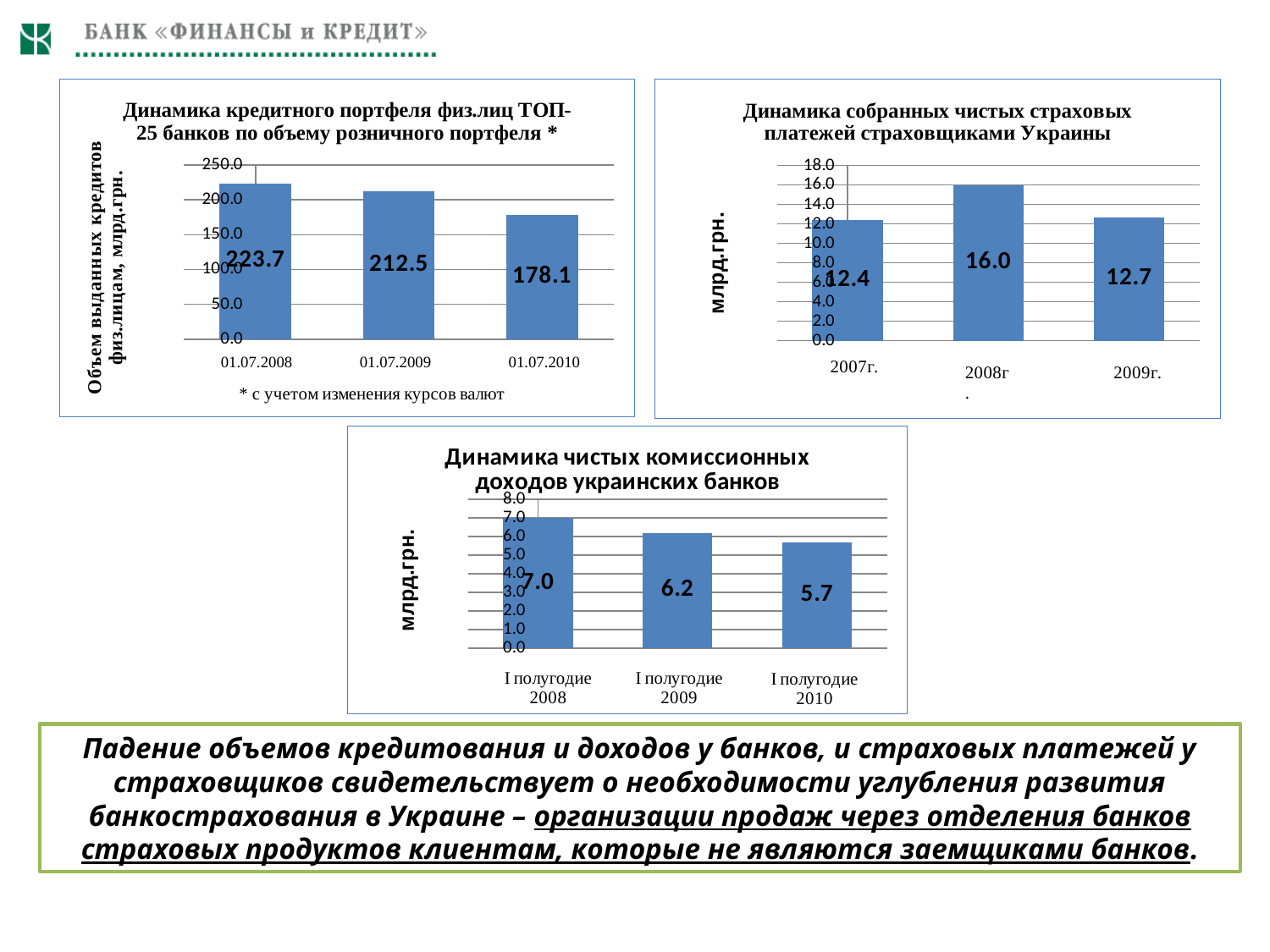
In the top-left chart (Динамика кредитного портфеля физ.лиц ТОП-25 банков), what is the difference between the values for 01.07.2008 and 01.07.2010? 45.6 In the top-left chart (Динамика кредитного портфеля физ.лиц ТОП-25 банков), what is the value for 01.07.2010? 178.1 In the top-left chart (Динамика кредитного портфеля физ.лиц ТОП-25 банков), which date has the highest value? 01.07.2008 In the top-right chart (Динамика собранных чистых страховых платежей страховщиками Украины), which is larger, the value for 2008г. or 2009г.? 2008г. In the top-right chart (Динамика собранных чистых страховых платежей страховщиками Украины), what is the difference between the values for 2008г. and 2007г.? 3.6 In the bottom chart (Динамика чистых комиссионных доходов украинских банков), what kind of chart is it? bar chart In the bottom chart (Динамика чистых комиссионных доходов украинских банков), what is the value for I полугодие 2009? 6.2 In the bottom chart (Динамика чистых комиссионных доходов украинских банков), what unit is shown on the y axis label? млрд.грн. In the top-right chart (Динамика собранных чистых страховых платежей страховщиками Украины), which year has the lowest value? 2007г. In the top-right chart (Динамика собранных чистых страховых платежей страховщиками Украины), what is the value for 2008г.? 16.0 In the bottom chart (Динамика чистых комиссионных доходов украинских банков), how many categories are shown on the x axis? 3 In the top-left chart (Динамика кредитного портфеля физ.лиц ТОП-25 банков), do the values rise or fall from 01.07.2008 to 01.07.2010? fall